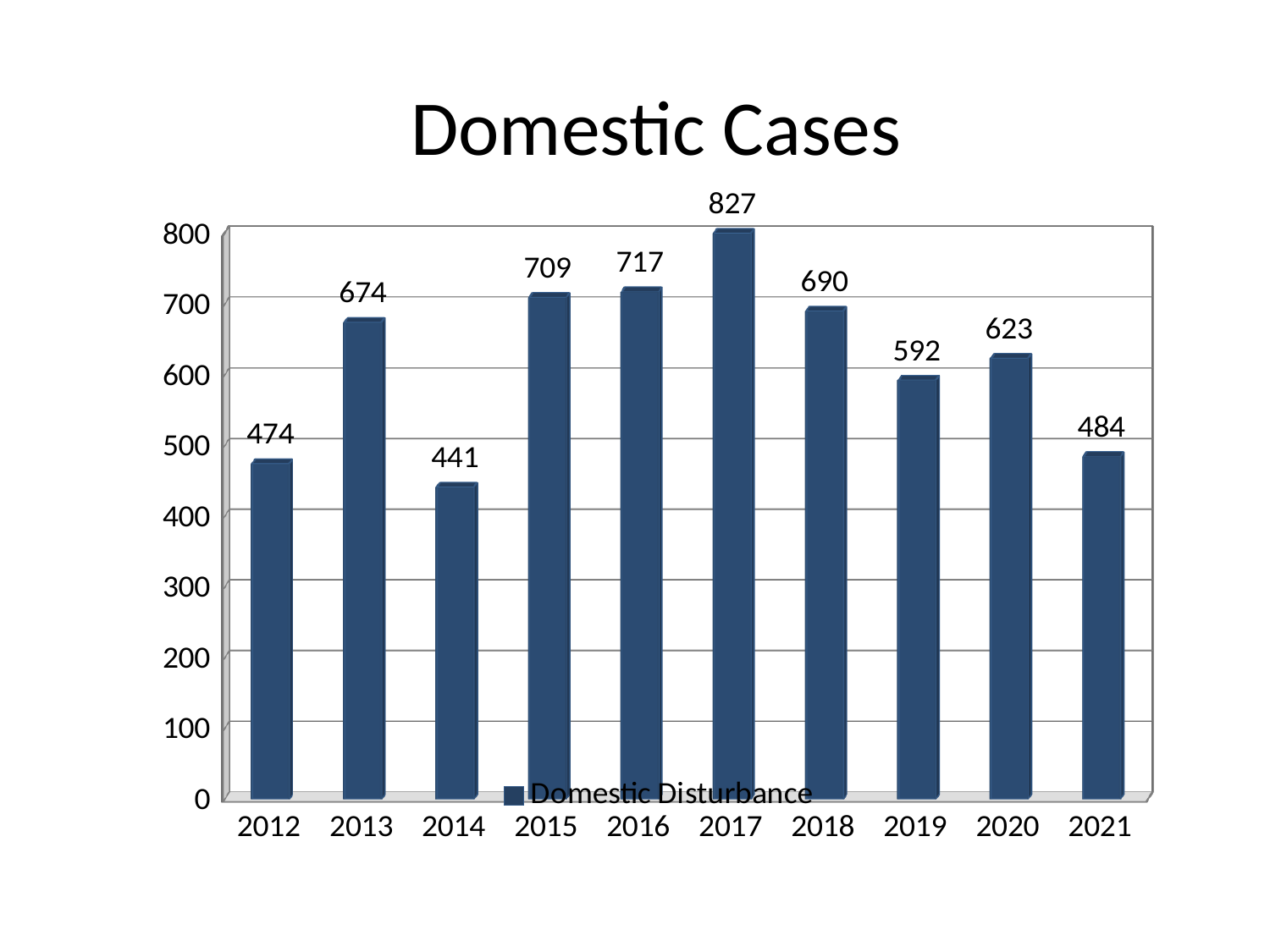
How many years are shown on the x axis? 10 What is the value for 2017? 827 Is the value for 2019 greater or less than 500? greater What is the difference between the values for 2013 and 2012? 200 What is the value for 2020? 623 Which year has the highest value? 2017 What is the value for 2014? 441 What kind of chart is shown? bar chart What is the series name shown in the legend? Domestic Disturbance Which is larger, the value for 2015 or the value for 2018? 2015 Which year has the lowest value? 2014 What is the difference between the values for 2017 and 2021? 343